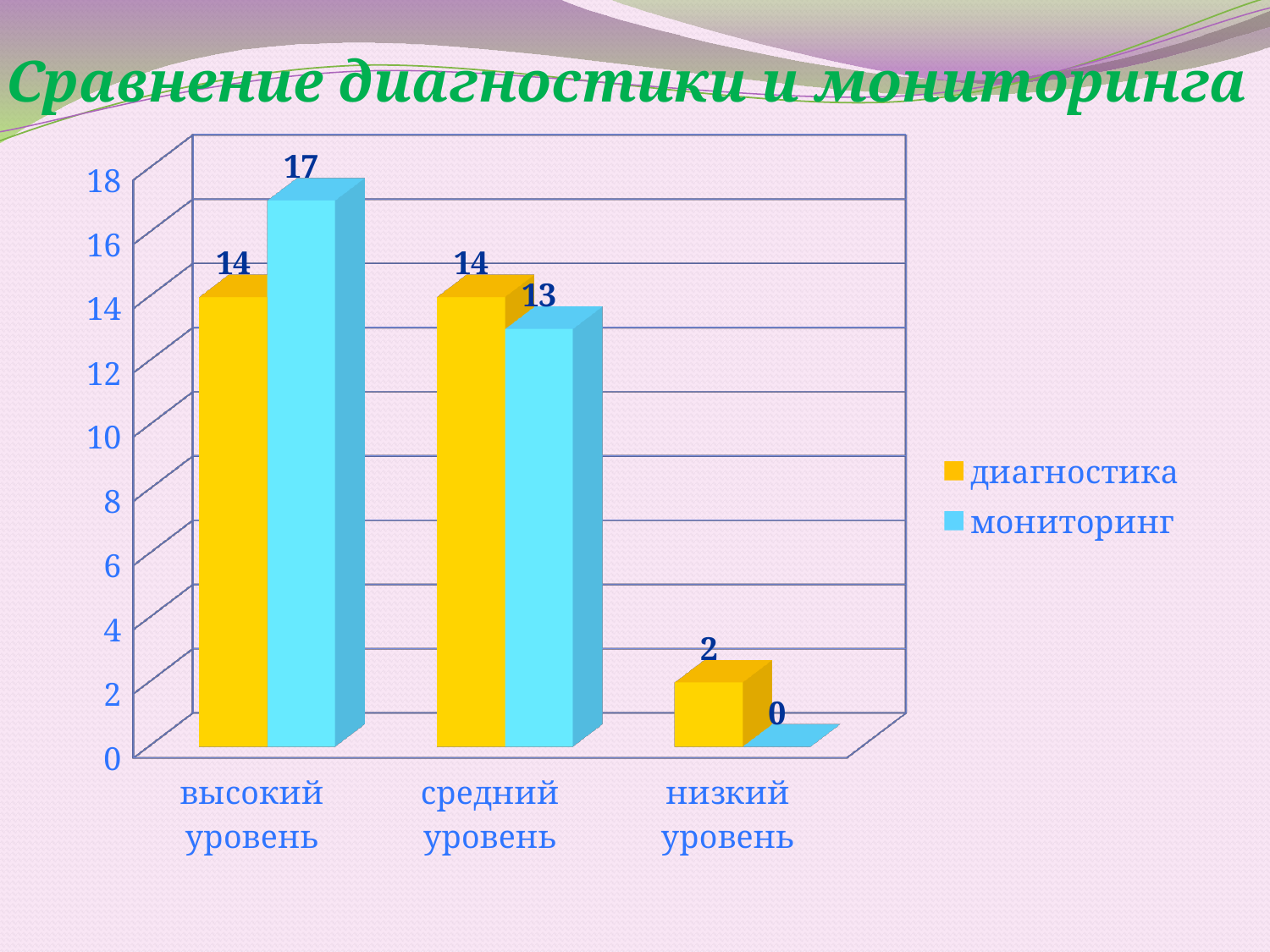
What kind of chart is shown on the slide? bar chart What is the value for мониторинг at средний уровень? 13 Which category has the highest value for мониторинг? высокий уровень At средний уровень, which series has the larger value, диагностика or мониторинг? диагностика What is the difference between мониторинг and диагностика at высокий уровень? 3 How many categories are shown on the x axis? 3 What is the value for мониторинг at низкий уровень? 0 Which category has the lowest value for диагностика? низкий уровень What is the value for мониторинг at высокий уровень? 17 How many series does the legend list? 2 What is the value for диагностика at высокий уровень? 14 What is the value for диагностика at низкий уровень? 2